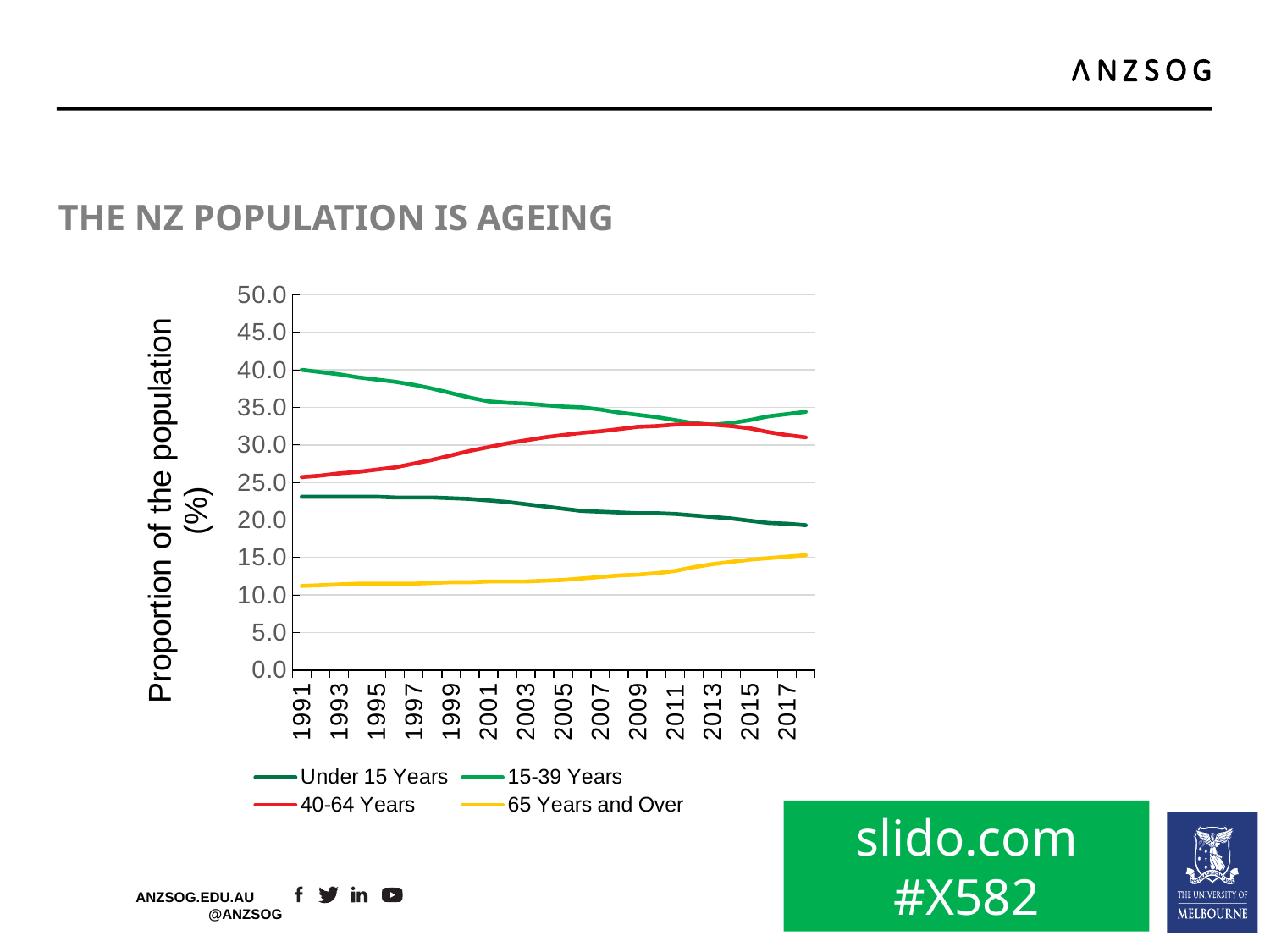
What is the title of the slide above the chart? THE NZ POPULATION IS AGEING Which series has the highest value in 1991? 15-39 Years Is the value for 15-39 Years in 1991 greater or less than 35.0? greater In 1991, which is larger: the value for 40-64 Years or the value for Under 15 Years? 40-64 Years What kind of chart is shown on the slide? line chart Is the value for 40-64 Years in 2011 greater or less than 30.0? greater Is the value for 65 Years and Over in 1991 greater or less than 15.0? less Which series has the lowest value in 2017? 65 Years and Over Does the value for 65 Years and Over rise or fall from 1991 to 2017? rise Does the value for Under 15 Years rise or fall from 1991 to 2017? fall How many series does the legend list? 4 Does the value for 15-39 Years rise or fall from 1991 to 2017? fall